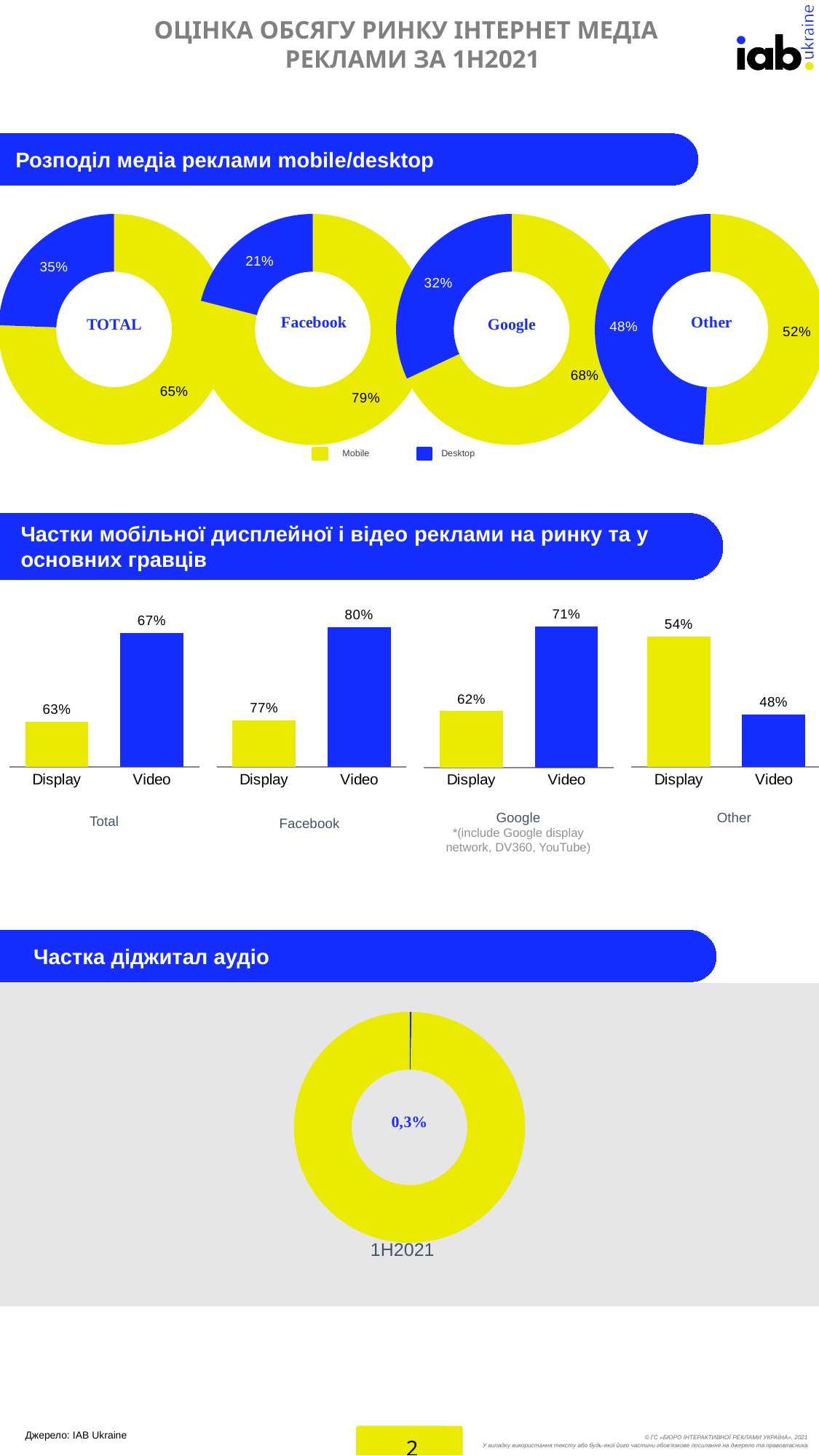
In the mobile/desktop donut chart labelled Google, what is the Mobile share? 68% In the bar chart labelled Facebook under 'Частки мобільної дисплейної і відео реклами', what is the difference between Video and Display? 3% In the bar chart labelled Google under 'Частки мобільної дисплейної і відео реклами', what is the value for Display? 62% In the mobile/desktop donut chart labelled Facebook, what is the Desktop share? 21% Among the four mobile/desktop donut charts, which one has the highest Mobile share? Facebook In the mobile/desktop donut chart labelled TOTAL, what is the Mobile share? 65% In the bar chart labelled Other under 'Частки мобільної дисплейної і відео реклами', which is larger, Display or Video? Display In the mobile/desktop donut chart labelled TOTAL, what is the difference between the Mobile and Desktop shares? 30% In the bar chart labelled Total under 'Частки мобільної дисплейної і відео реклами', what is the value for Video? 67% In the mobile/desktop donut chart labelled Other, what is the Desktop share? 48% How many series does the legend of the mobile/desktop donut charts list? 2 In the 'Частка діджитал аудіо' donut chart, what share is shown for 1H2021? 0,3%